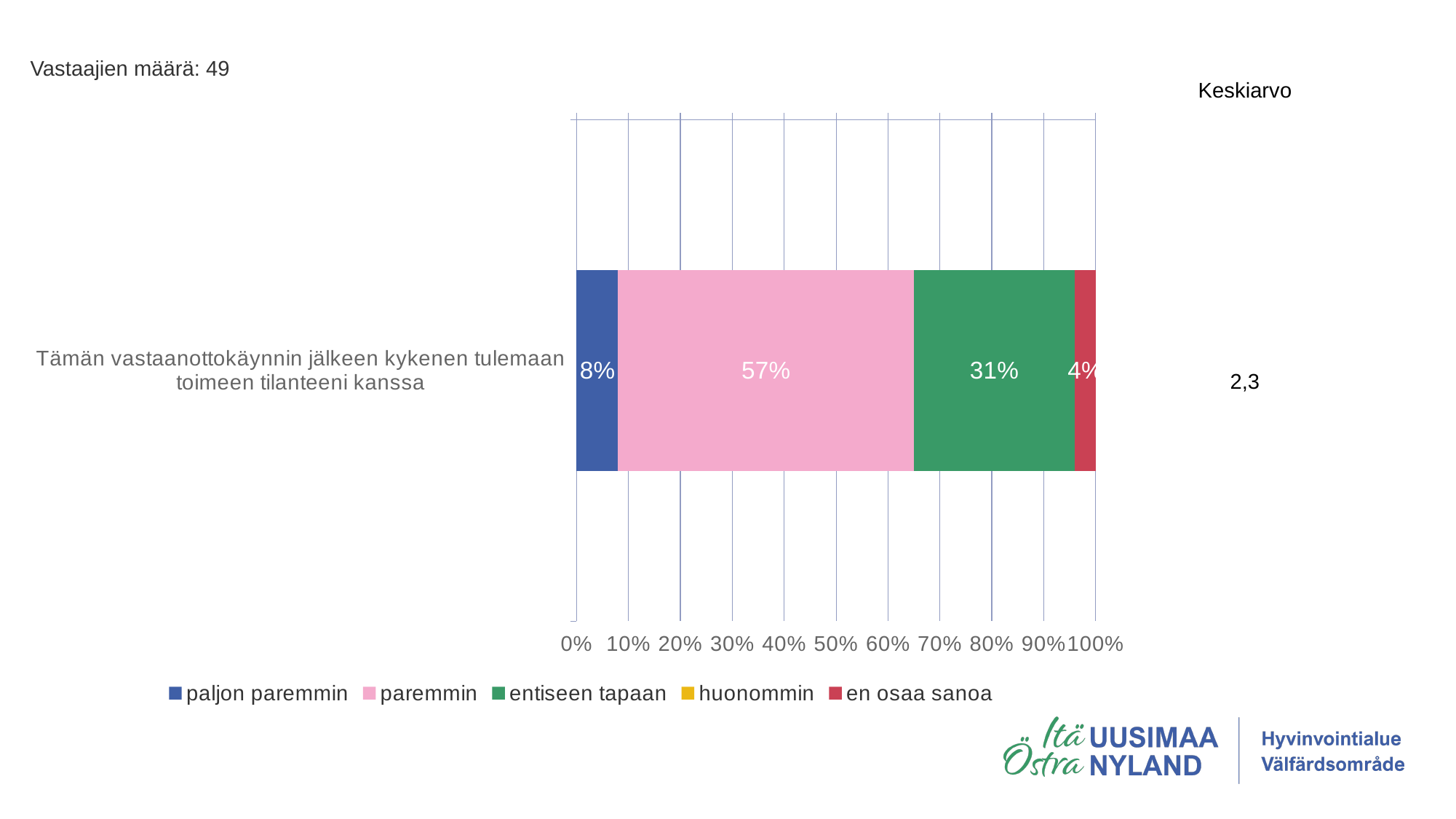
Is the share for "paremmin" greater or less than 50%? greater What kind of chart is shown on the slide? Stacked bar chart What percentage of respondents answered "paljon paremmin"? 8% Which response option has the largest share? paremmin What percentage of respondents answered "entiseen tapaan"? 31% How many series does the legend list? 5 What is the difference between the "paremmin" and "entiseen tapaan" shares? 26 percentage points How many respondents (Vastaajien määrä) are reported on the slide? 49 Which is larger, the share for "paljon paremmin" or the share for "entiseen tapaan"? entiseen tapaan What percentage of respondents answered "en osaa sanoa"? 4% What is the Keskiarvo (mean) value shown for the statement? 2,3 What percentage of respondents answered "paremmin"? 57%